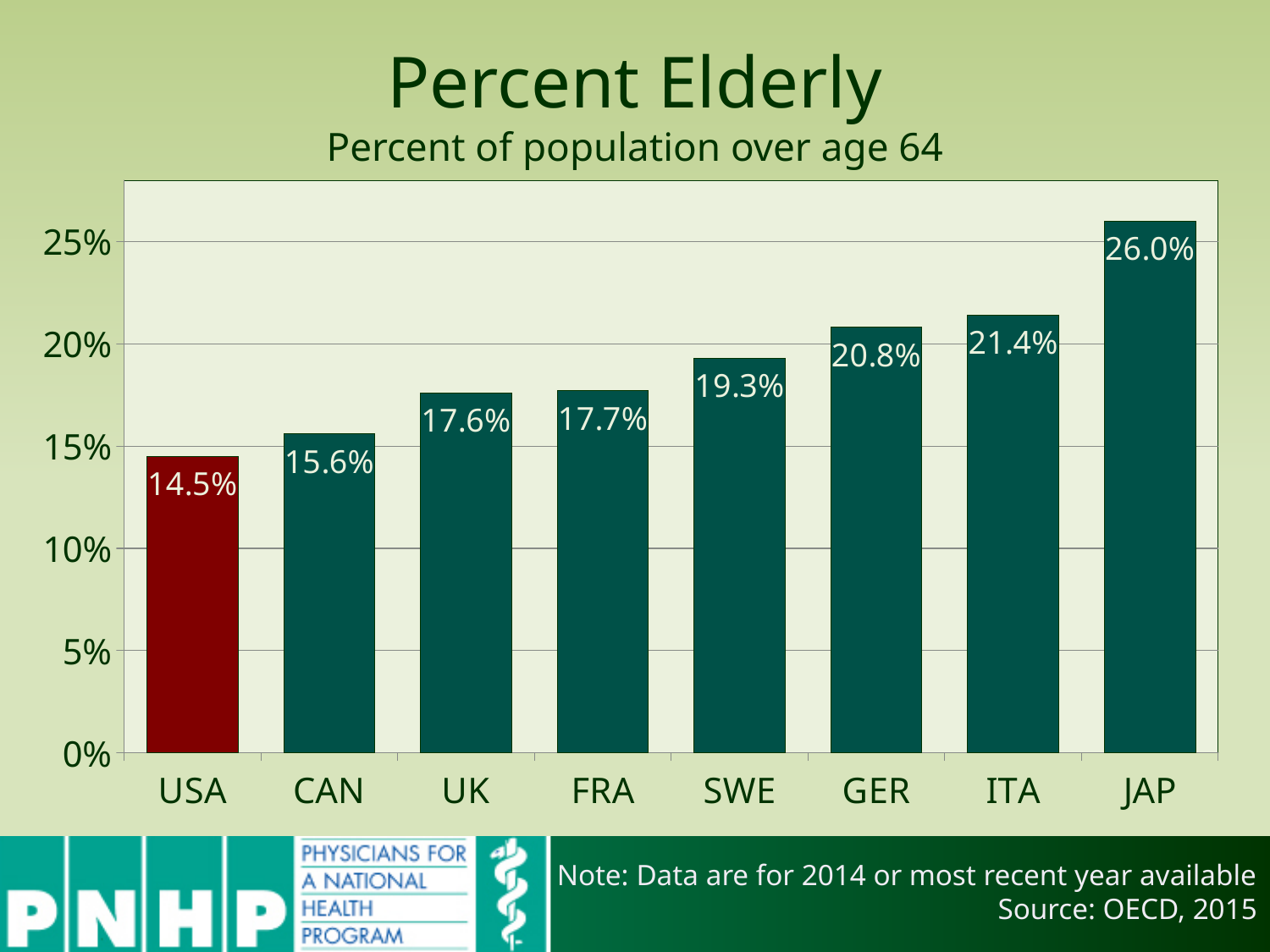
Which country has the lowest percent of population over age 64? USA Which has a higher percent elderly, Canada or Sweden? SWE What is the percent elderly value for Germany (GER)? 20.8% How many countries are shown in the chart? 8 What is the difference between Italy's and Germany's percent elderly values? 0.6% Which country has the highest percent of population over age 64? JAP Is the value for Japan greater or less than 25%? greater What is the difference between Japan's and the USA's percent elderly values? 11.5% What kind of chart is shown on the slide? Bar chart Which country's bar is coloured dark red instead of green? USA What is the percent elderly value for the USA? 14.5% What is the percent elderly value for Sweden (SWE)? 19.3%